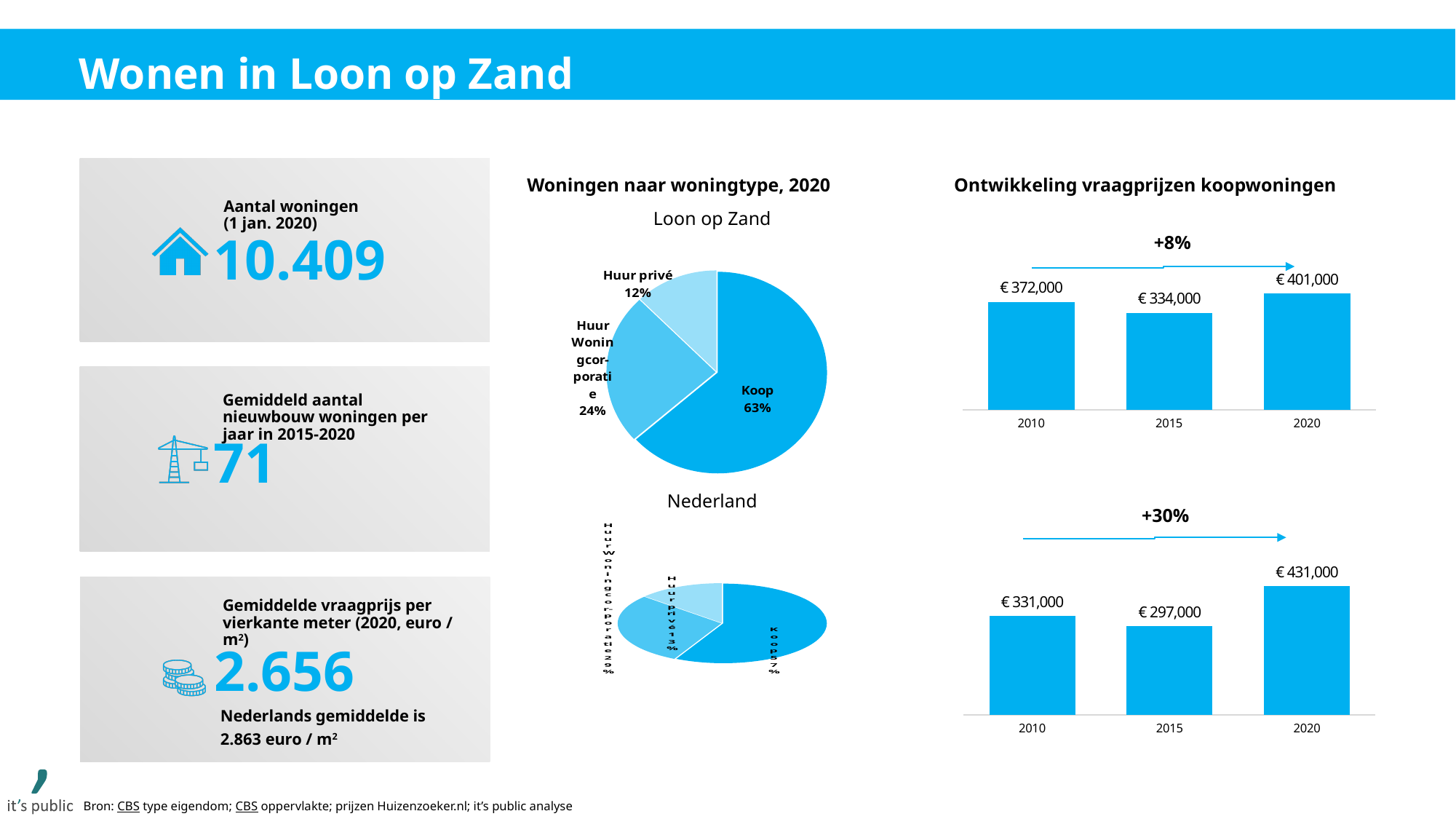
In the 'Loon op Zand' pie chart, what share is labelled for Huur Woningcorporatie? 24% What percentage change is shown above the lower bar chart under 'Ontwikkeling vraagprijzen koopwoningen'? +30% In the lower bar chart under 'Ontwikkeling vraagprijzen koopwoningen', what is the difference between the 2020 and 2010 values? € 100,000 In the 'Loon op Zand' pie chart, which category has the smallest slice? Huur privé In the 'Loon op Zand' pie chart, what share is labelled for Koop? 63% In the upper bar chart under 'Ontwikkeling vraagprijzen koopwoningen', what is the value for 2020? € 401,000 How many slices does the 'Loon op Zand' pie chart have? 3 In the 'Loon op Zand' pie chart, what share is labelled for Huur privé? 12% What kind of chart is used for 'Woningen naar woningtype, 2020'? Pie chart In the 'Loon op Zand' pie chart, which category has the largest slice? Koop In the upper bar chart under 'Ontwikkeling vraagprijzen koopwoningen', which year has the lowest value? 2015 In the lower bar chart under 'Ontwikkeling vraagprijzen koopwoningen', which year has the highest value? 2020